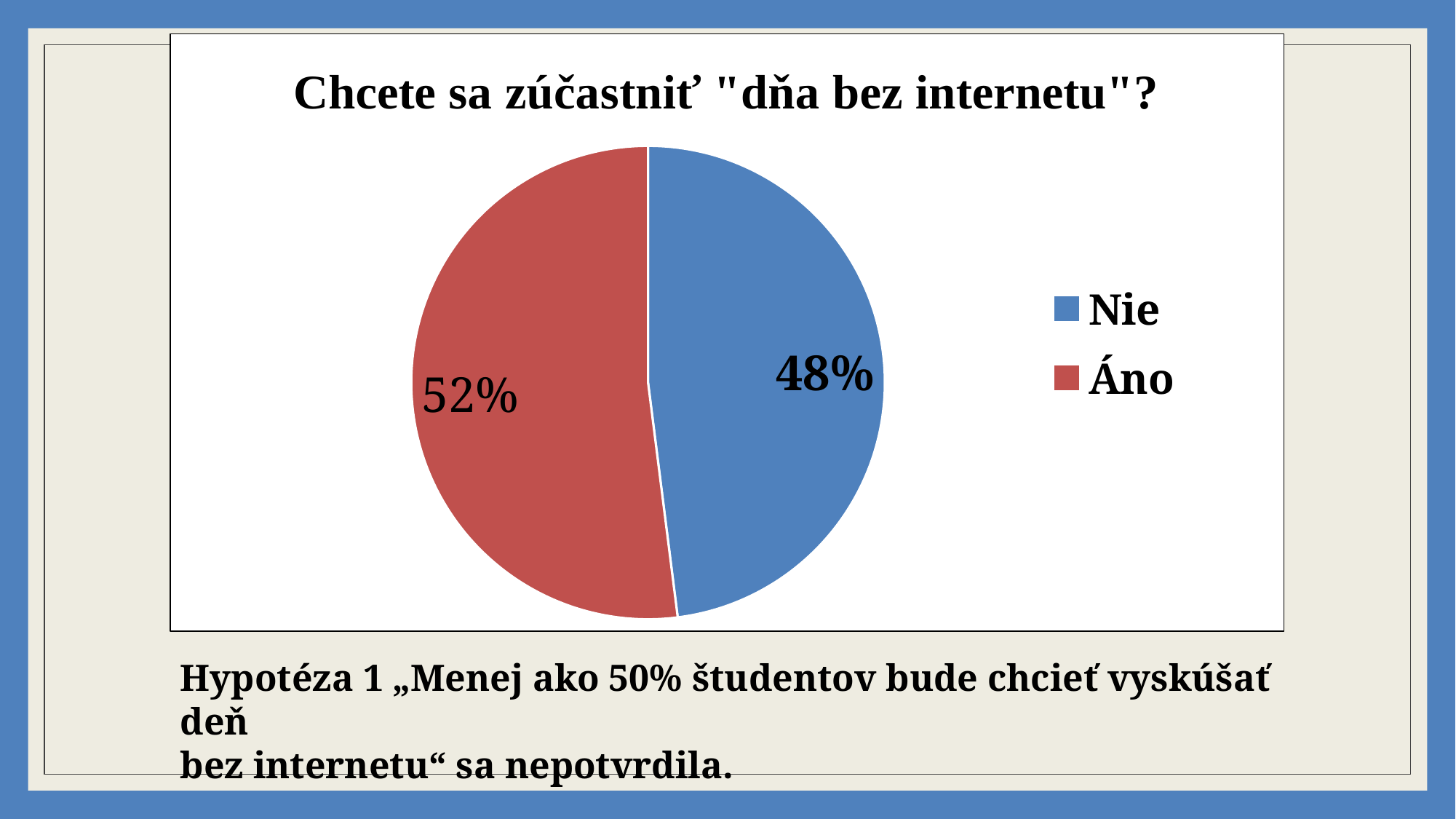
What percentage of the pie is labelled "Nie"? 48% What percentage of the pie is labelled "Áno"? 52% Which slice is the largest? Áno What is the title of the chart? Chcete sa zúčastniť "dňa bez internetu"? How many slices does the pie chart have? 2 What colour is the "Nie" slice? blue How many entries does the legend list? 2 Which is larger, the "Áno" slice or the "Nie" slice? Áno What type of chart is shown on the slide? pie chart What is the difference in percentage points between the "Áno" and "Nie" slices? 4 What share of the pie does the "Áno" slice represent? 52% Which slice is the smallest? Nie